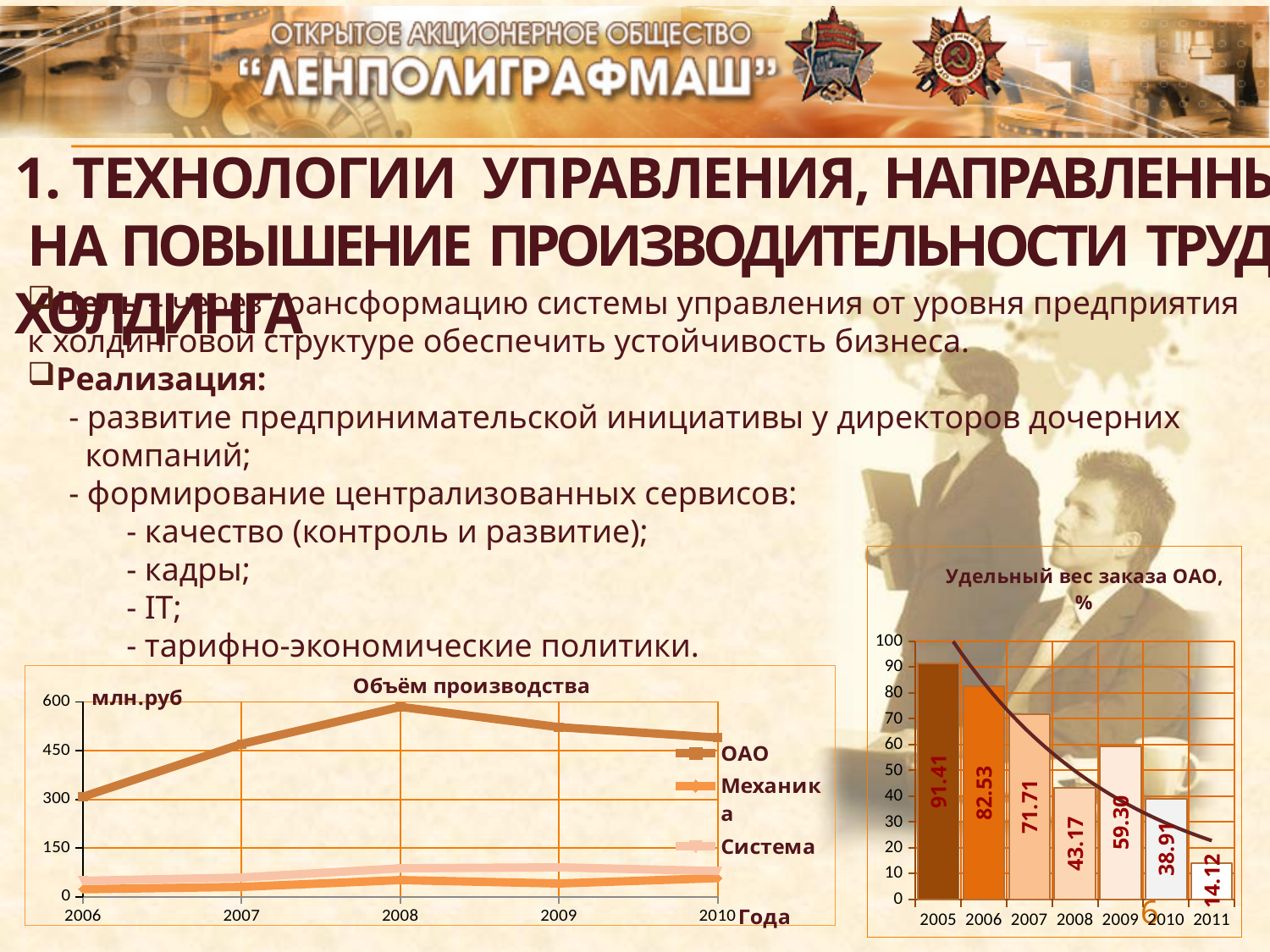
In the chart titled "Удельный вес заказа ОАО, %", which is larger, the value for 2008 or the value for 2009? 2009 What kind of chart is the one titled "Удельный вес заказа ОАО, %"? bar chart In the chart titled "Объём производства", is the value for ОАО in 2008 greater or less than 450? greater In the chart titled "Удельный вес заказа ОАО, %", what is the value for 2005? 91.41 In the chart titled "Удельный вес заказа ОАО, %", which year has the highest value? 2005 In the chart titled "Объём производства", how many series does the legend list? 3 In the chart titled "Удельный вес заказа ОАО, %", what is the value for 2009? 59.30 In the chart titled "Удельный вес заказа ОАО, %", what is the difference between the values for 2005 and 2006? 8.88 In the chart titled "Объём производства", which series has the highest values across all years? ОАО In the chart titled "Удельный вес заказа ОАО, %", what is the value for 2011? 14.12 In the chart titled "Удельный вес заказа ОАО, %", how many years are shown on the x axis? 7 In the chart titled "Удельный вес заказа ОАО, %", which year has the lowest value? 2011